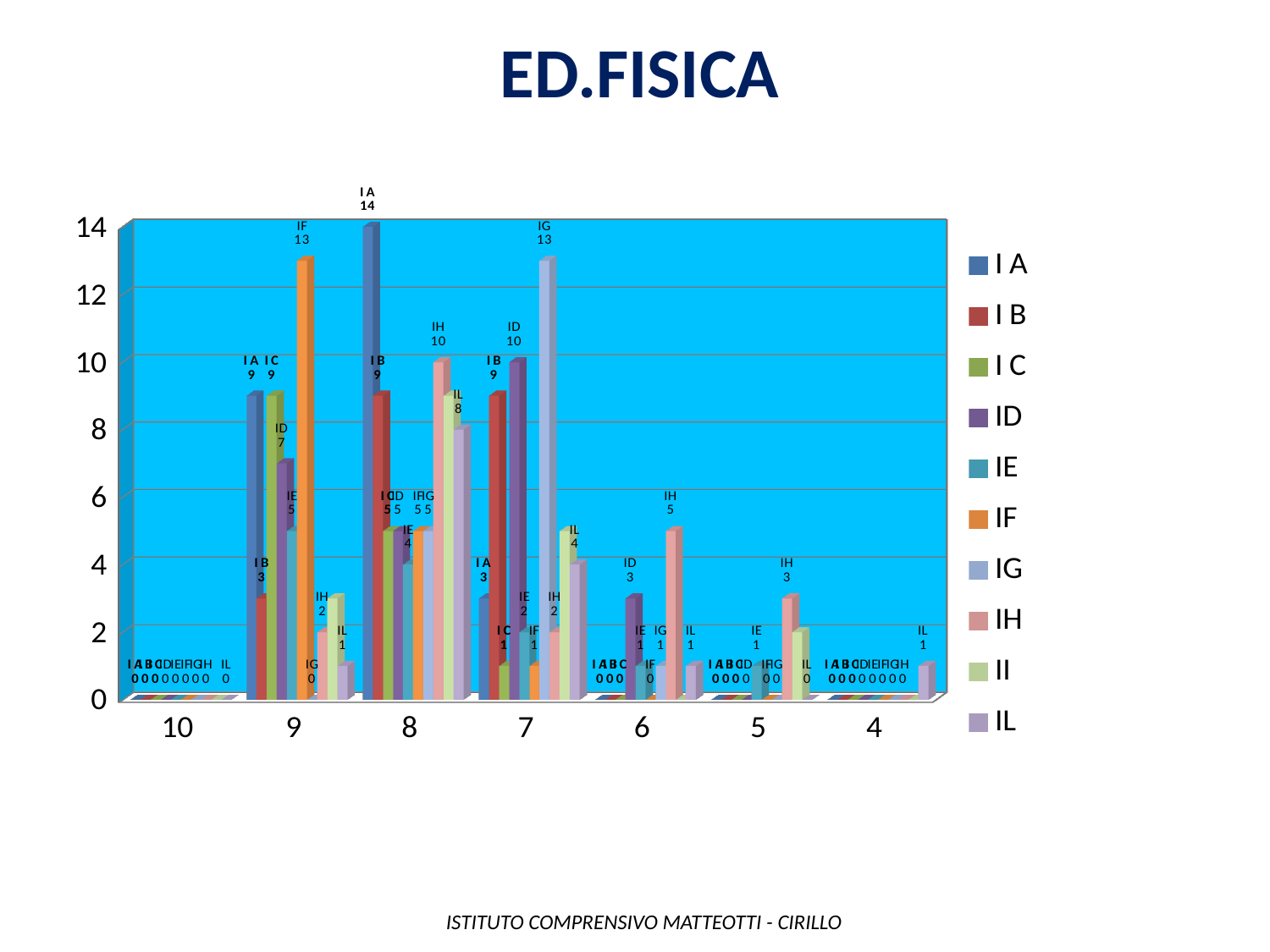
In category 9, which is larger: the value for IF or the value for IE? IF What is the value for series IH in category 6? 5 What is the difference between the values for I A and I B in category 8? 5 What is the value for series IF in category 9? 13 What type of chart is shown on the slide? bar chart How many series does the legend list? 10 What is the value for series ID in category 9? 7 How many categories are shown on the x axis? 7 Which series has the highest bar in category 8? I A What is the value for series I A in category 8? 14 What is the title of the chart? ED.FISICA What is the value for series IG in category 7? 13